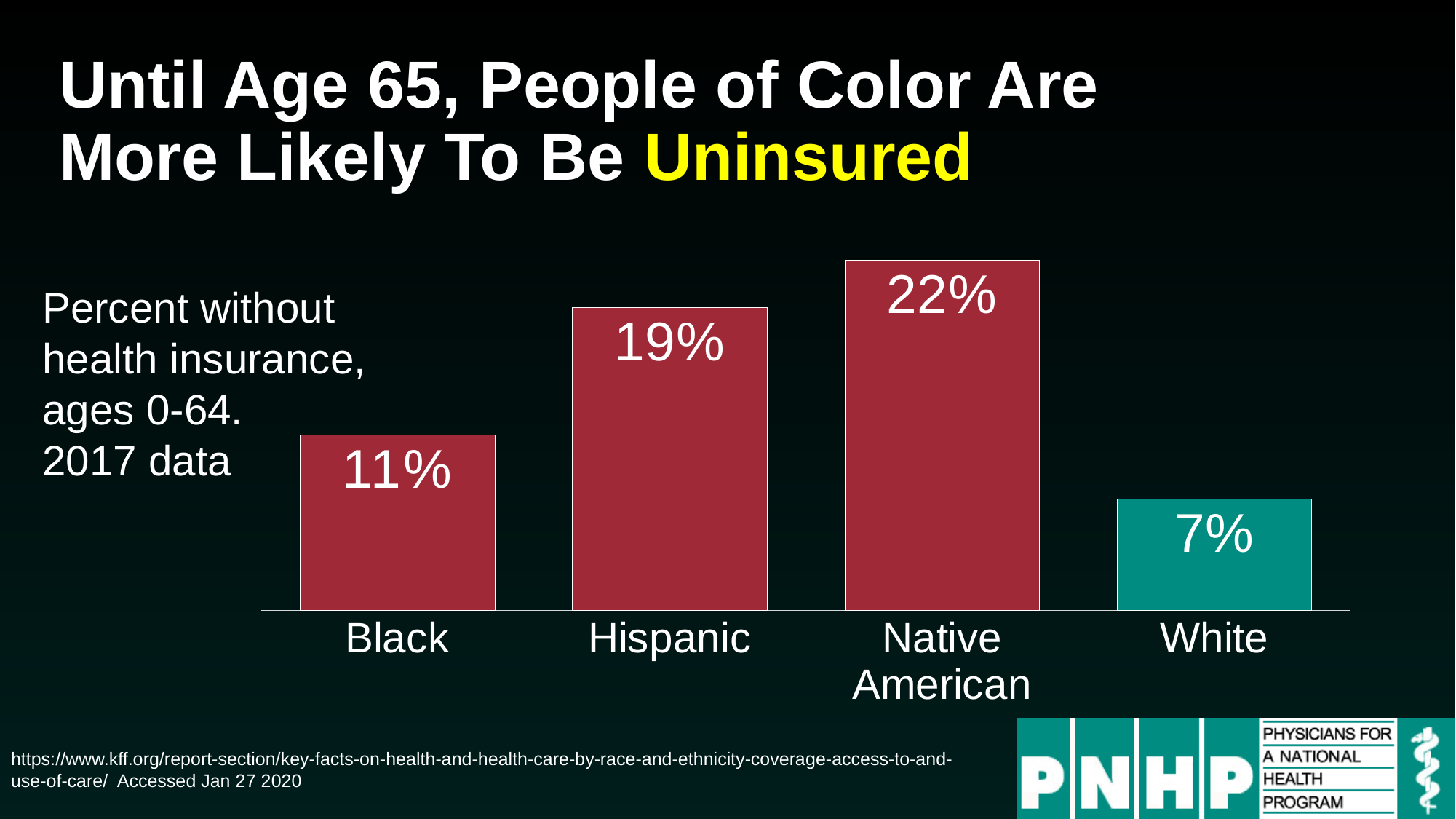
Which group has a higher uninsured rate, Black or Hispanic? Hispanic Which group has the highest percent without health insurance? Native American What is the percent without health insurance for Native American people? 22% What kind of chart is shown on the slide? Bar chart What is the percent without health insurance for Black people? 11% What is the difference in percentage points between the Hispanic and Black uninsured rates? 8 Which bar is shown in a different colour (teal) from the others? White What is the difference in percentage points between the Native American and White uninsured rates? 15 Which group has the lowest percent without health insurance? White What is the percent without health insurance for White people? 7% What is the percent without health insurance for Hispanic people? 19% How many groups are shown in the chart? 4